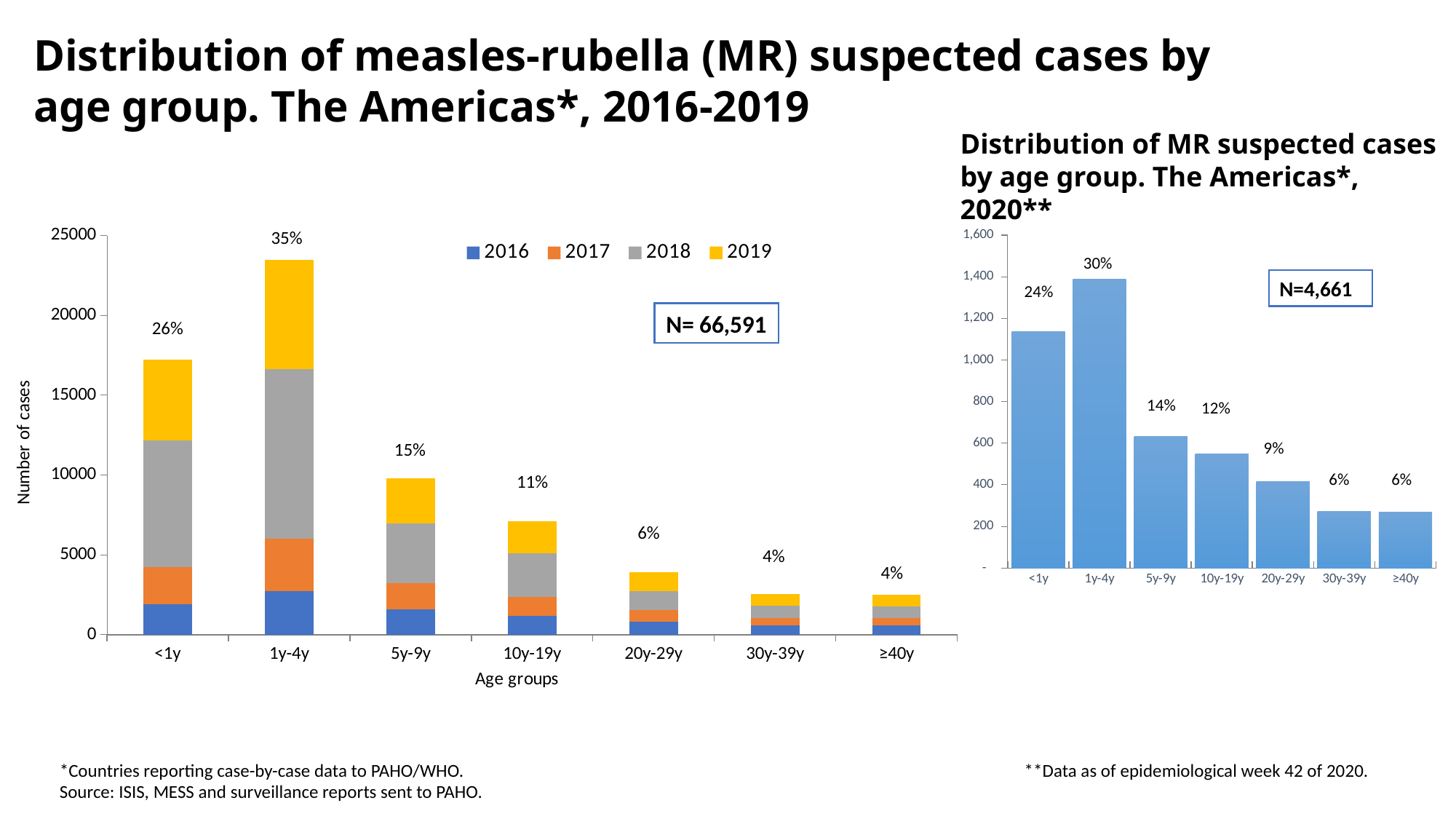
In the 2020 chart on the right, what percentage label is shown for the <1y age group? 24% In the 2016-2019 chart on the left, what is the difference in percentage points between the 1y-4y and <1y labels? 9 In the 2016-2019 chart on the left, which age group has the tallest stacked bar? 1y-4y In the 2016-2019 chart on the left, is the total stacked value for the 1y-4y age group greater or less than 20000? greater In the 2020 chart on the right, is the value for the 30y-39y age group greater or less than 400? less In the 2016-2019 chart on the left, what percentage label is shown for the 10y-19y age group? 11% What kind of chart is the 2016-2019 chart on the left? Stacked bar chart In the 2016-2019 chart on the left, what percentage label is shown for the 1y-4y age group? 35% How many age groups are shown on the x axis of the 2020 chart on the right? 7 How many series does the legend of the 2016-2019 chart on the left list? 4 In the 2020 chart on the right, which age group has the highest number of cases? 1y-4y In the 2020 chart on the right, which is larger: the percentage for 5y-9y or for 10y-19y? 5y-9y